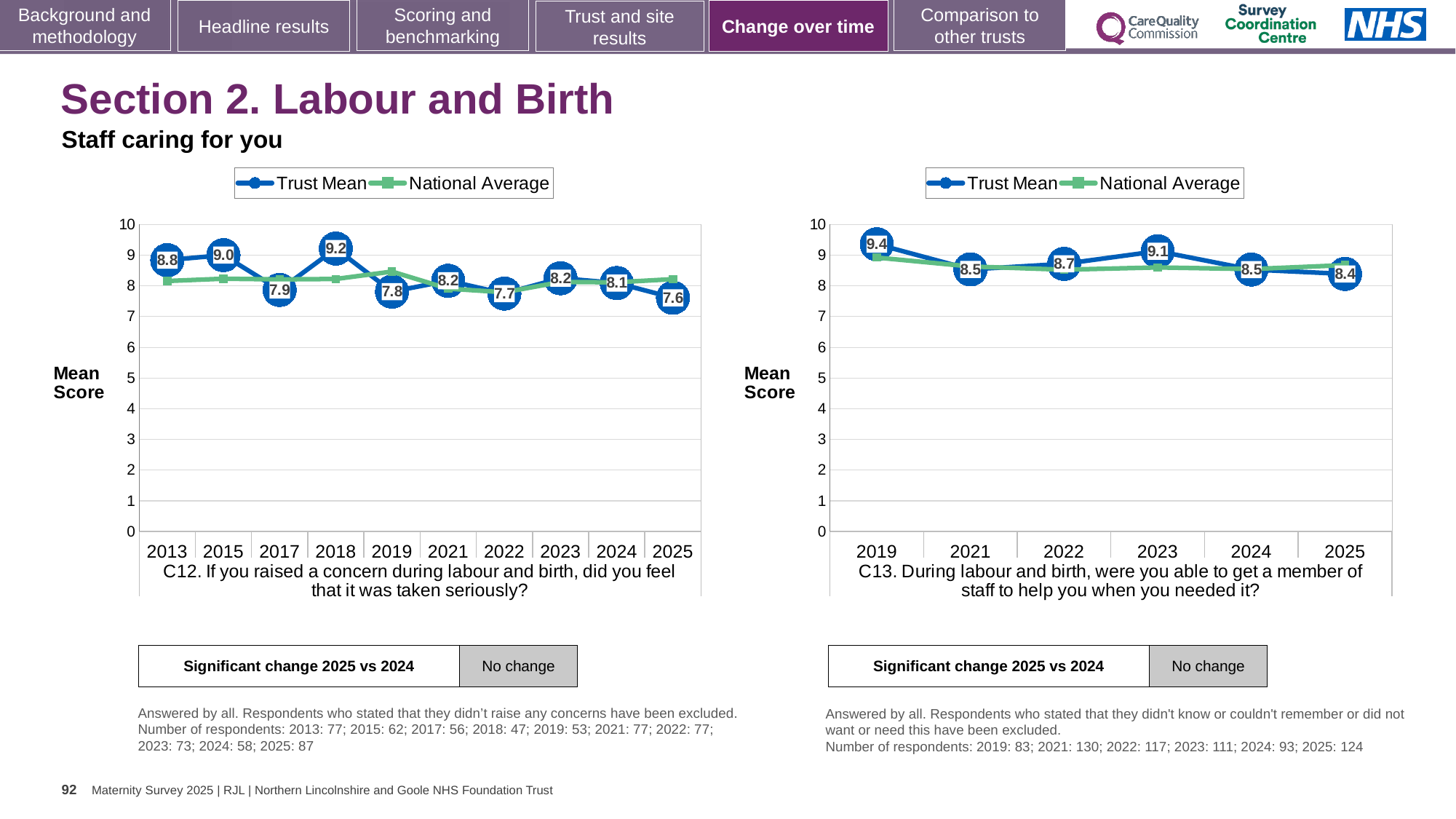
In the left chart (C12), which year has the lowest Trust Mean? 2025 In the left chart (C12), what is the difference between the Trust Mean in 2018 and in 2025? 1.6 In the right chart (C13), which year has the highest Trust Mean? 2019 In the left chart (C12), how many years are shown on the x axis? 10 In the left chart (C12), what is the Trust Mean for 2018? 9.2 In the right chart (C13), is the Trust Mean for 2023 larger or smaller than the Trust Mean for 2024? larger In the left chart (C12), which year has the highest Trust Mean? 2018 In the left chart (C12), what is the Trust Mean for 2025? 7.6 In the right chart (C13), what is the Trust Mean for 2019? 9.4 In the right chart (C13), what is the difference between the Trust Mean in 2019 and in 2025? 1.0 What kind of chart is the left chart (C12)? Line chart How many series does the legend of the right chart (C13) list? 2